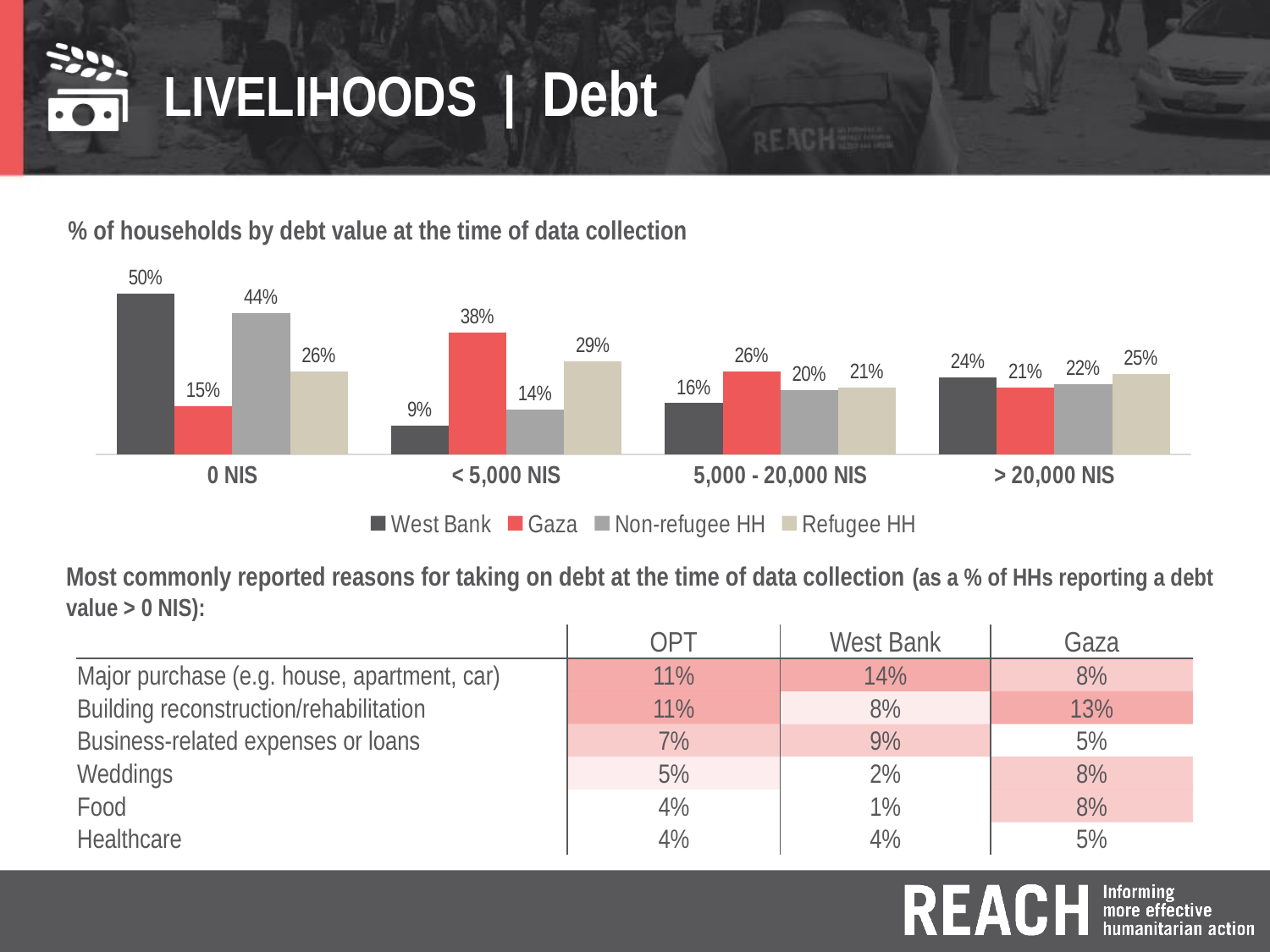
What percentage of Gaza households reported a debt value of < 5,000 NIS? 38% What is the value for Non-refugee HH in the 5,000 - 20,000 NIS category? 20% Which series has the lowest value in the < 5,000 NIS category? West Bank Which series has the highest value in the 0 NIS category? West Bank What is the value for Refugee HH in the > 20,000 NIS category? 25% What type of chart is shown on the slide? bar chart What percentage of West Bank households reported a debt value of 0 NIS? 50% How many series does the chart legend list? 4 What is the difference between the West Bank and Gaza values in the 0 NIS category? 35% What is the title of the chart? % of households by debt value at the time of data collection In the 5,000 - 20,000 NIS category, which is larger: the Gaza value or the West Bank value? Gaza How many debt value categories are shown on the x axis of the chart? 4